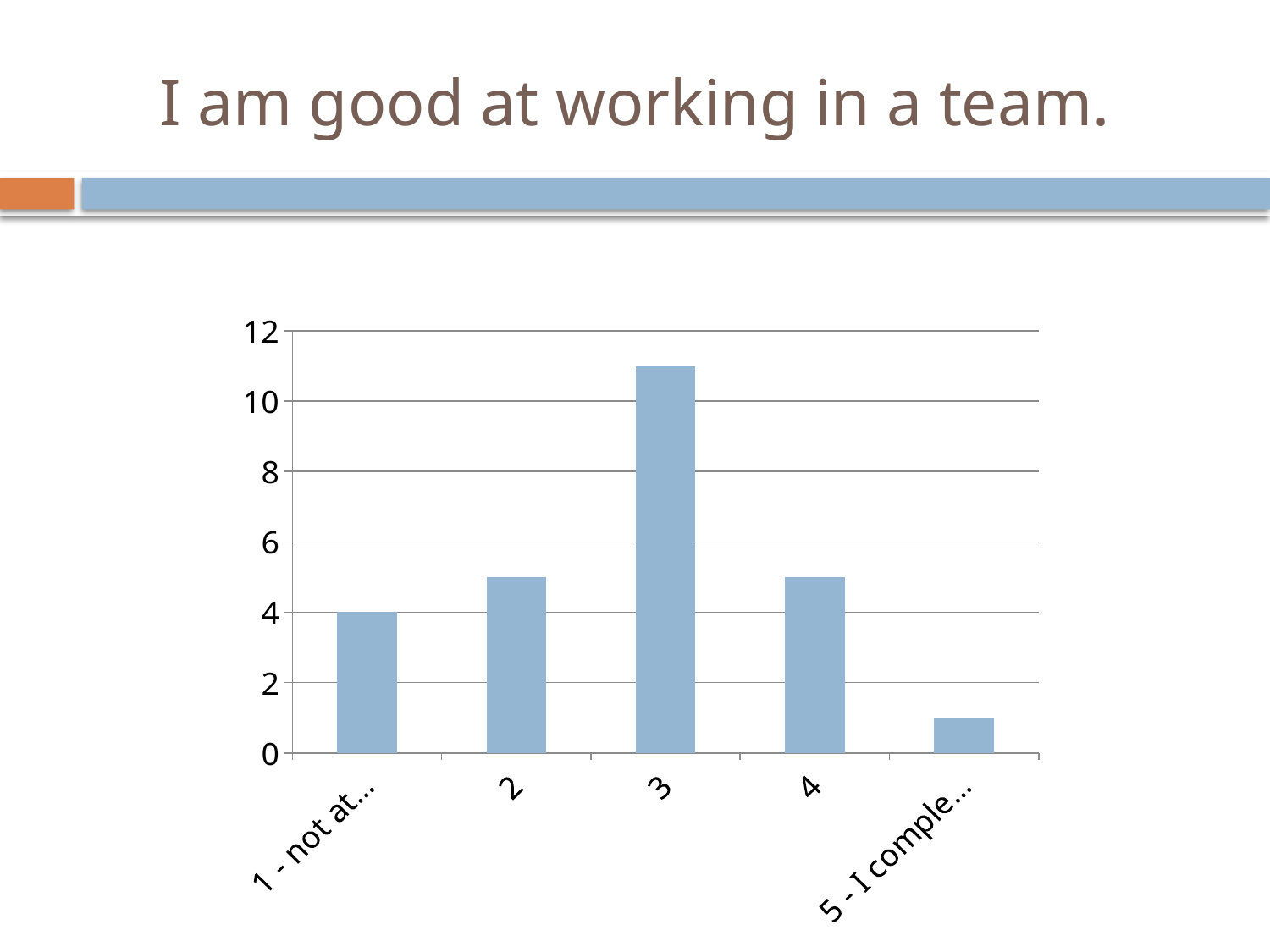
Is the value for category 3 greater or less than 10? greater Is the value for the last category, "5 - I comple...", greater or less than 2? less What is the title of the slide containing the chart? I am good at working in a team. Is the value for category 2 greater or less than 4? greater Which has the larger value, the first category "1 - not at..." or the last category "5 - I comple..."? 1 - not at... Which category has the highest bar? 3 What kind of chart is shown on the slide? bar chart What is the value for the first category, "1 - not at..."? 4 Which category has the lowest bar? 5 - I comple... Which has the larger value, category 3 or category 4? 3 How many categories are shown on the x axis of the chart? 5